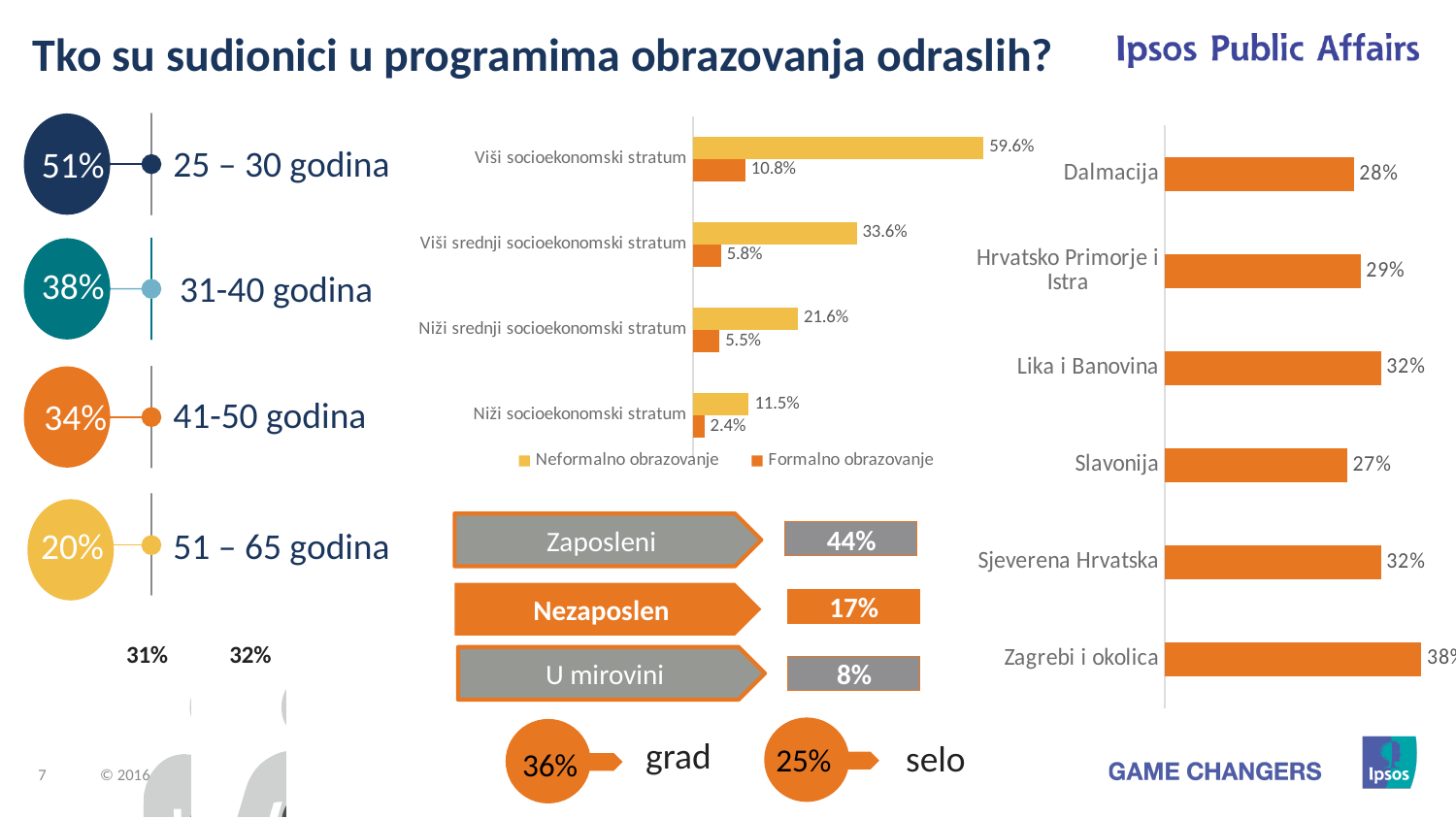
What kind of chart is the socioeconomic stratum chart in the middle of the slide? Bar chart In the regions chart on the right of the slide, what is the value for Slavonija? 27% In the socioeconomic stratum chart in the middle of the slide, what is the difference between the Neformalno obrazovanje and Formalno obrazovanje values for Viši srednji socioekonomski stratum? 27.8% In the regions chart on the right of the slide, which is larger, the value for Dalmacija or the value for Lika i Banovina? Lika i Banovina In the regions chart on the right of the slide, what is the difference between the values for Hrvatsko Primorje i Istra and Dalmacija? 1% In the socioeconomic stratum chart in the middle of the slide, what is the value for Formalno obrazovanje for Niži socioekonomski stratum? 2.4% In the regions chart on the right of the slide, which region has the highest value? Zagrebi i okolica In the socioeconomic stratum chart in the middle of the slide, how many series does the legend list? 2 In the socioeconomic stratum chart in the middle of the slide, how many categories are shown? 4 In the regions chart on the right of the slide, which region has the lowest value? Slavonija In the socioeconomic stratum chart in the middle of the slide, which category has the highest Neformalno obrazovanje value? Viši socioekonomski stratum In the socioeconomic stratum chart in the middle of the slide, what is the value for Neformalno obrazovanje for Viši socioekonomski stratum? 59.6%